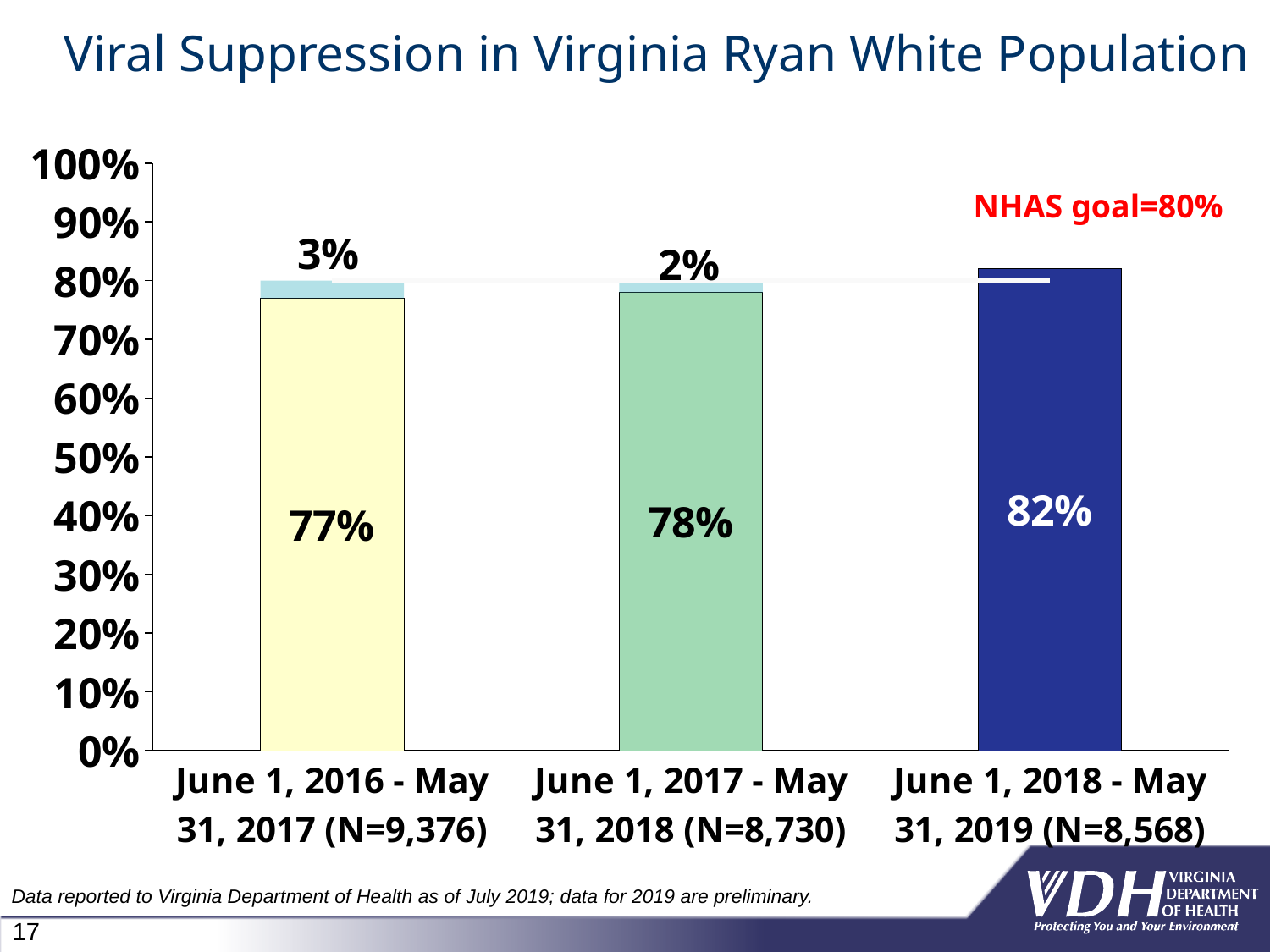
What is the value of the small top segment on the June 1, 2016 - May 31, 2017 bar? 3% What is the value of the small top segment on the June 1, 2017 - May 31, 2018 bar? 2% What is the total of the stacked bar for June 1, 2016 - May 31, 2017? 80% What is the difference between the viral suppression percentage for June 1, 2018 - May 31, 2019 and June 1, 2016 - May 31, 2017? 5% How many time periods are shown on the x axis? 3 What is the NHAS goal shown on the chart? 80% What is the viral suppression percentage for June 1, 2016 - May 31, 2017 (N=9,376)? 77% Which period has the lowest main viral suppression percentage? June 1, 2016 - May 31, 2017 (N=9,376) What is the viral suppression percentage for June 1, 2018 - May 31, 2019 (N=8,568)? 82% Which period has the highest viral suppression percentage? June 1, 2018 - May 31, 2019 (N=8,568) What kind of chart is shown on the slide? Bar chart What is the viral suppression percentage for June 1, 2017 - May 31, 2018 (N=8,730)? 78%